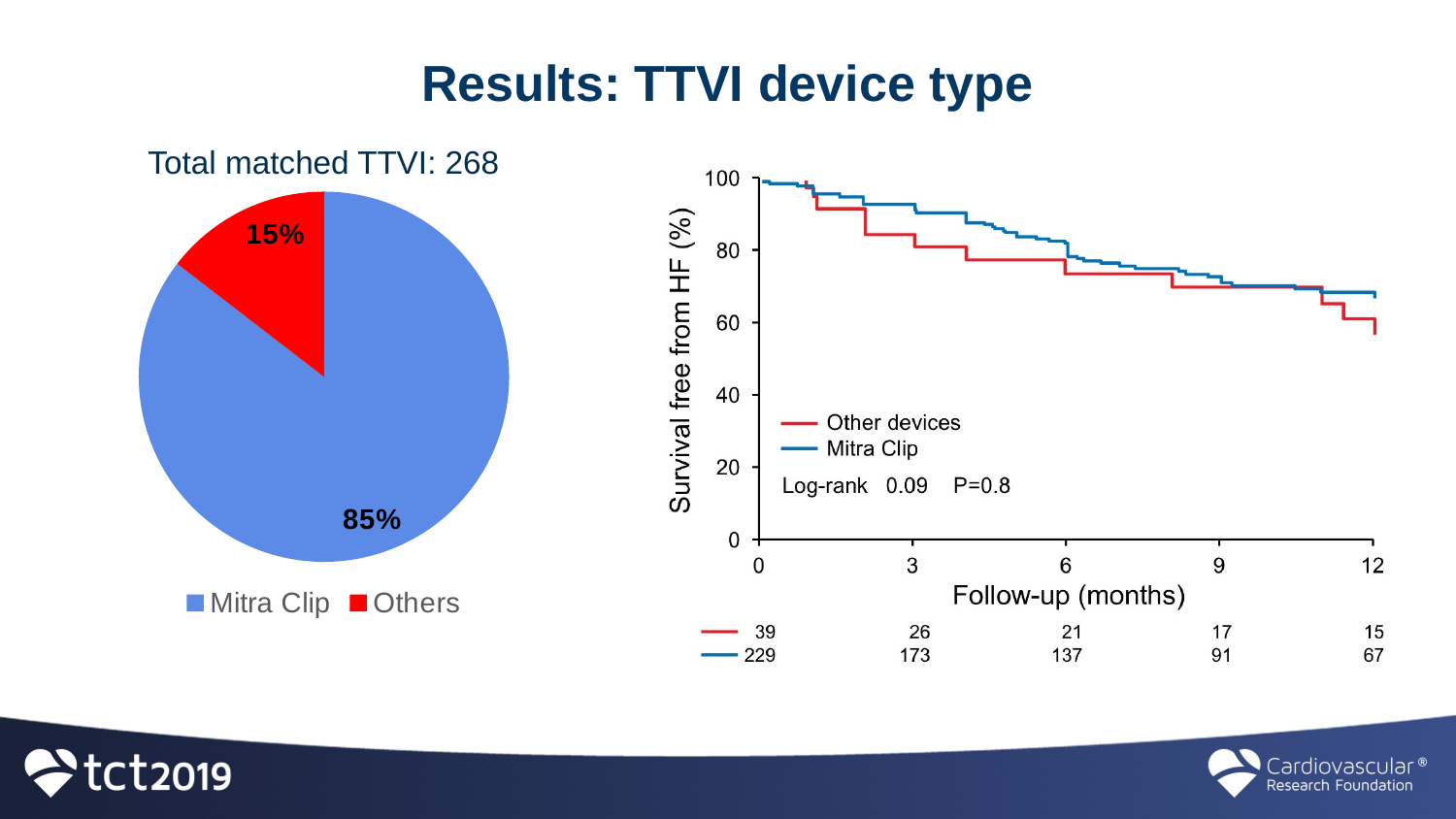
In the survival chart on the right, how many series does the legend list? 2 How many categories does the legend of the pie chart on the left list? 2 In the survival chart on the right, what is the difference between the numbers at risk for Mitra Clip and Other devices at 6 months? 116 In the pie chart on the left, what share of matched TTVI patients received a Mitra Clip? 85% What type of chart is shown on the left of the slide? Pie chart In the survival chart on the right, what is the number at risk for the Other devices group at 12 months? 15 In the survival chart on the right, what is the number at risk for the Mitra Clip group at 0 months? 229 In the pie chart on the left, what share of matched TTVI patients received other devices? 15% In the survival chart on the right, does survival free from HF rise or fall as follow-up months increase? Fall What is the total number of matched TTVI patients stated above the pie chart? 268 In the pie chart on the left, which category has the larger slice, Mitra Clip or Others? Mitra Clip In the survival chart on the right, which colour represents the Mitra Clip group? Blue